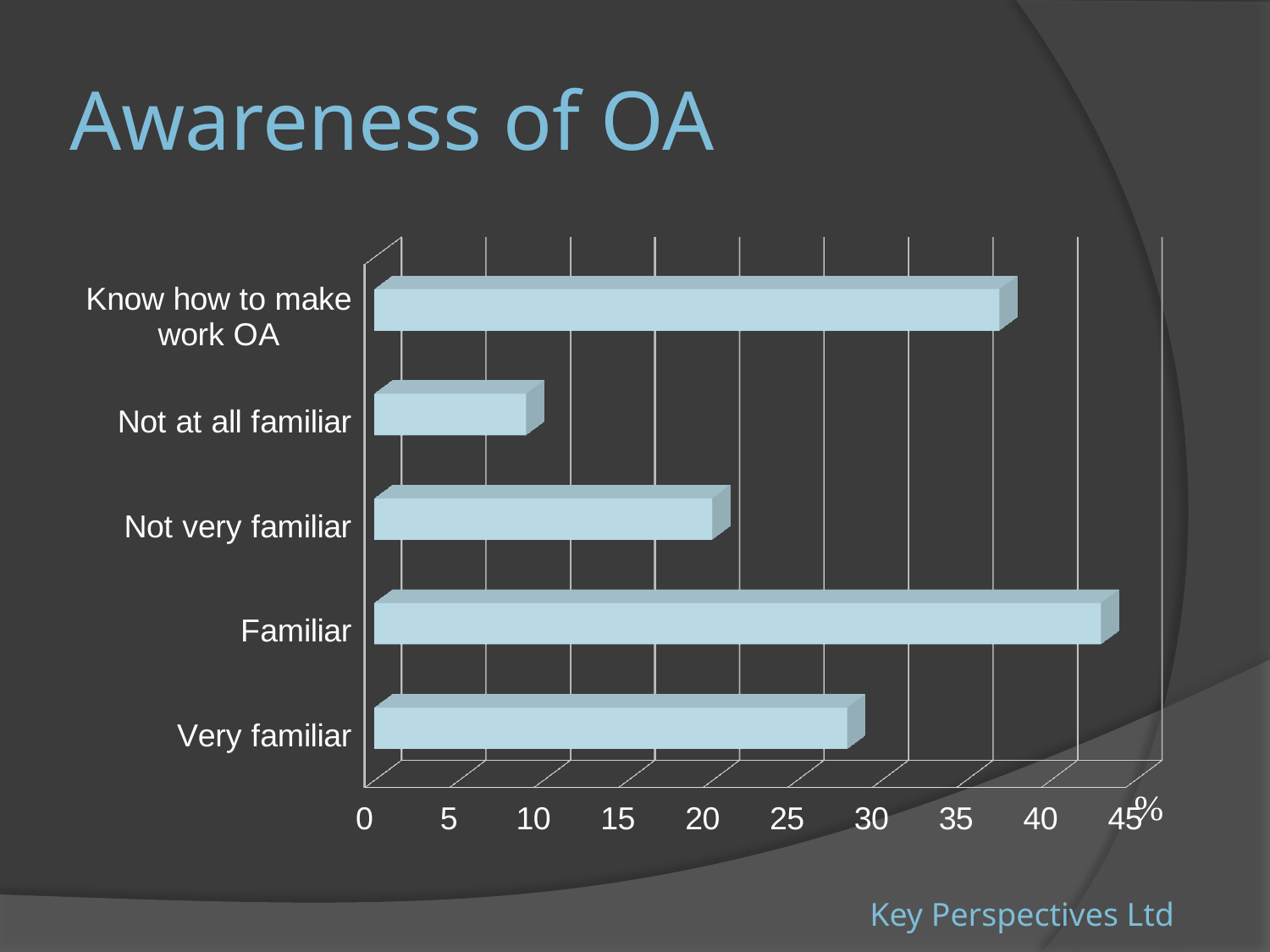
Which is larger, the value for Very familiar or the value for Not very familiar? Very familiar How many categories are plotted in the chart? 5 Is the value for Not at all familiar greater or less than 15? less What kind of chart is shown on the slide? bar chart Is the value for Familiar greater or less than 40? greater Which category has the lowest value? Not at all familiar Is the value for Very familiar greater or less than 25? greater Which is larger, the value for Familiar or the value for Know how to make work OA? Familiar Which category has the highest value? Familiar What is the title of the slide containing the chart? Awareness of OA